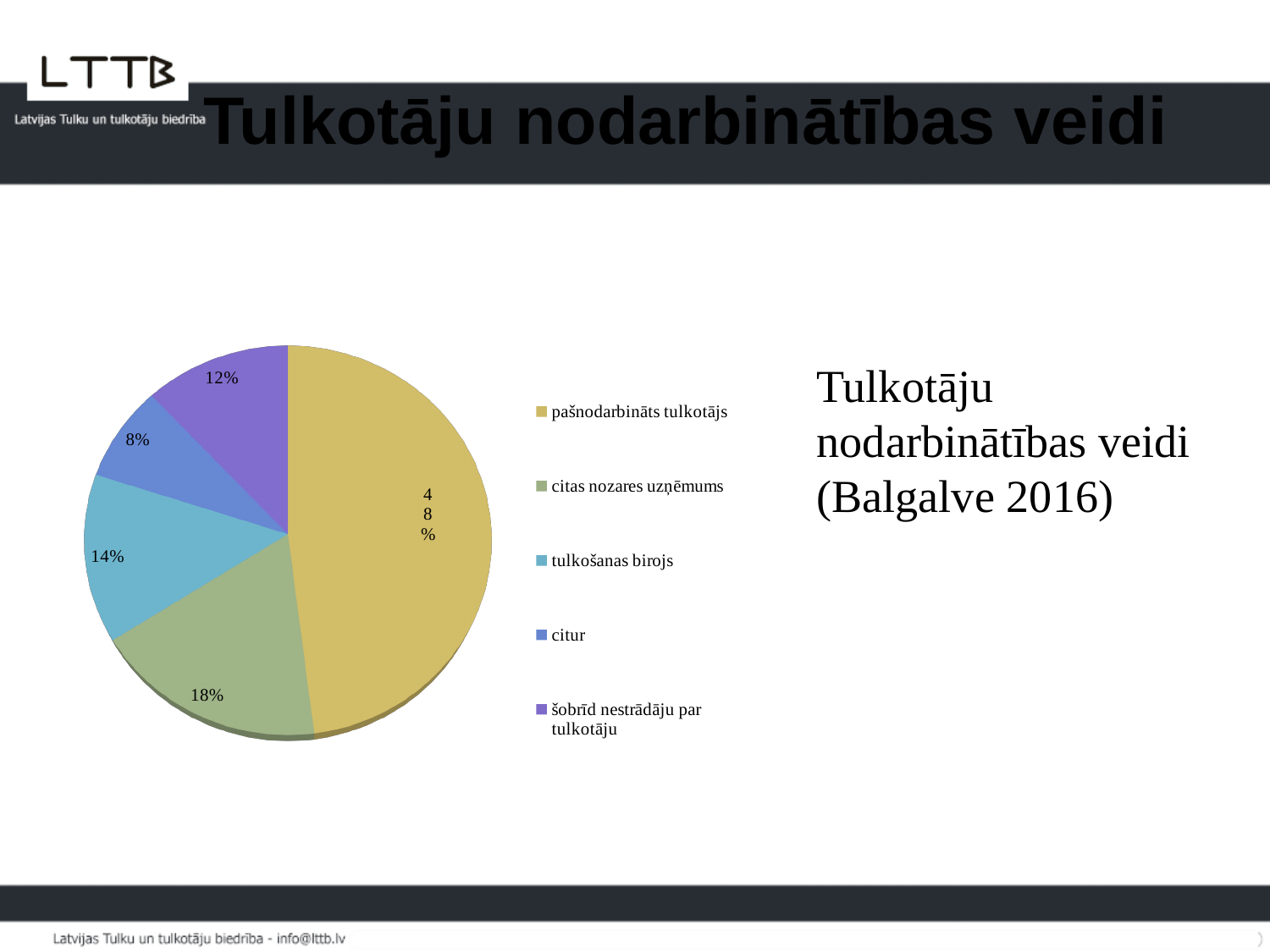
What kind of chart is shown on the slide? pie chart What share of the pie does "šobrīd nestrādāju par tulkotāju" have? 12% What share of the pie does "citur" have? 8% How many slices does the pie chart have? 5 What colour is the slice for "pašnodarbināts tulkotājs"? yellow What is the difference in percentage points between "pašnodarbināts tulkotājs" and "citas nozares uzņēmums"? 30 Which category has the smallest slice of the pie? citur What share of the pie does "tulkošanas birojs" have? 14% What share of the pie does "citas nozares uzņēmums" have? 18% What share of the pie does "pašnodarbināts tulkotājs" have? 48% Which category has the largest slice of the pie? pašnodarbināts tulkotājs Which is larger: the slice for "tulkošanas birojs" or the slice for "šobrīd nestrādāju par tulkotāju"? tulkošanas birojs